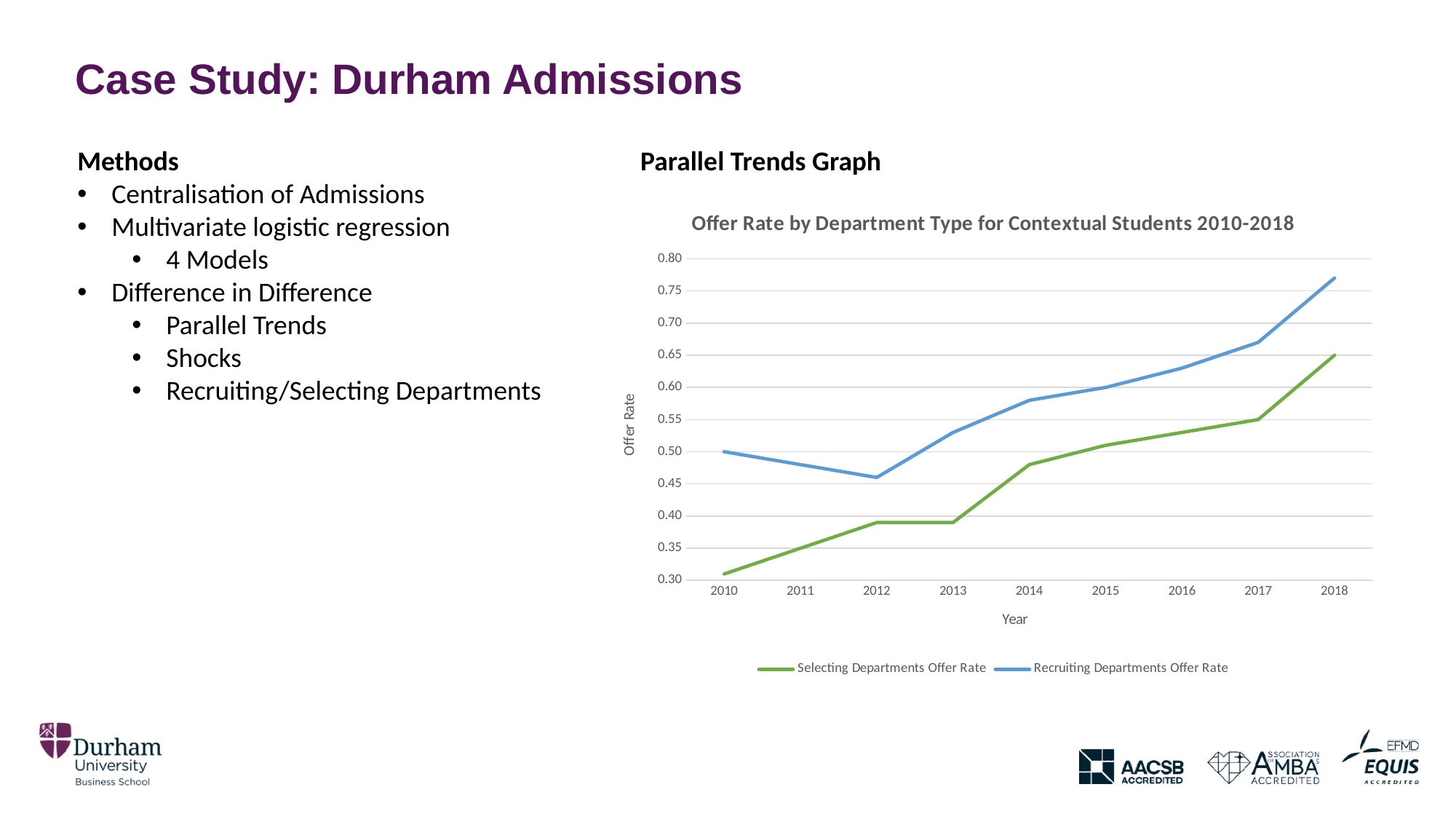
In which year is the Selecting Departments Offer Rate lowest? 2010 Is the Recruiting Departments Offer Rate in 2018 greater or less than 0.75? greater How many series does the legend of the chart list? 2 What is the title of the chart? Offer Rate by Department Type for Contextual Students 2010-2018 Is the Selecting Departments Offer Rate in 2014 greater or less than 0.50? less What kind of chart is shown on the slide? Line chart Does the Selecting Departments Offer Rate rise or fall from 2010 to 2018? rise In which year is the Recruiting Departments Offer Rate lowest? 2012 How many years are plotted along the x axis of the chart? 9 In 2014, which series has the higher offer rate, Selecting Departments or Recruiting Departments? Recruiting Departments Offer Rate What is the label of the vertical axis of the chart? Offer Rate In which year is the Recruiting Departments Offer Rate highest? 2018